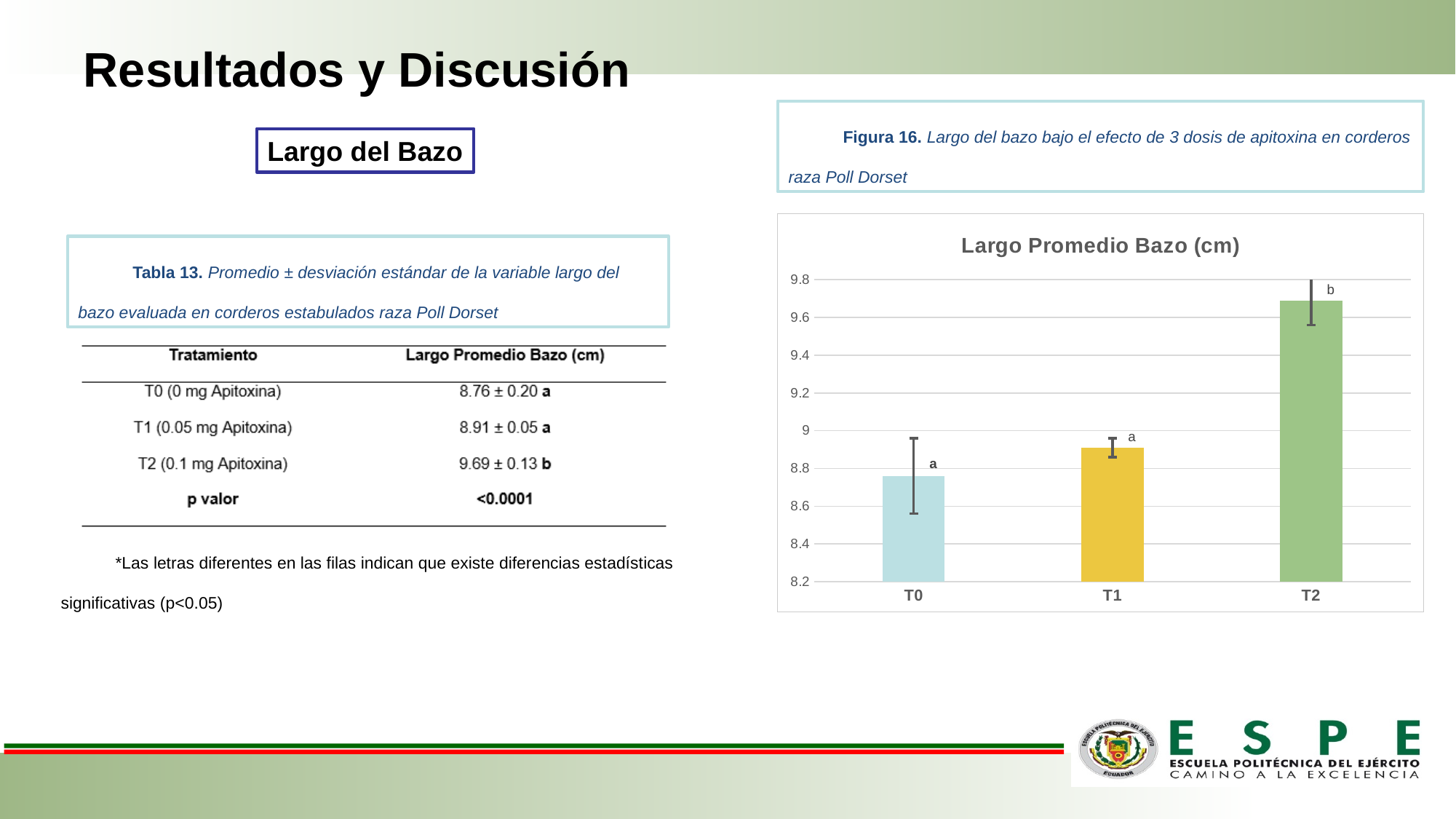
What letter label is shown above the T2 bar in the "Largo Promedio Bazo (cm)" chart? b Which treatment has the highest bar in the "Largo Promedio Bazo (cm)" chart? T2 According to the slide, what is the average spleen length (Largo Promedio Bazo) for T2 plotted in the chart? 9.69 Which treatment has the lowest bar in the "Largo Promedio Bazo (cm)" chart? T0 In the "Largo Promedio Bazo (cm)" chart, is the bar for T1 greater or less than 9? less How many treatment categories are plotted in the "Largo Promedio Bazo (cm)" chart? 3 Do the bar values rise or fall from T0 to T2 in the "Largo Promedio Bazo (cm)" chart? rise In the "Largo Promedio Bazo (cm)" chart, is the bar for T0 greater or less than 8.8? less What colour is the T1 bar in the "Largo Promedio Bazo (cm)" chart? yellow In the "Largo Promedio Bazo (cm)" chart, which bar is taller, T1 or T2? T2 What type of chart is shown under the title "Largo Promedio Bazo (cm)"? bar chart In the "Largo Promedio Bazo (cm)" chart, is the bar for T2 greater or less than 9.4? greater